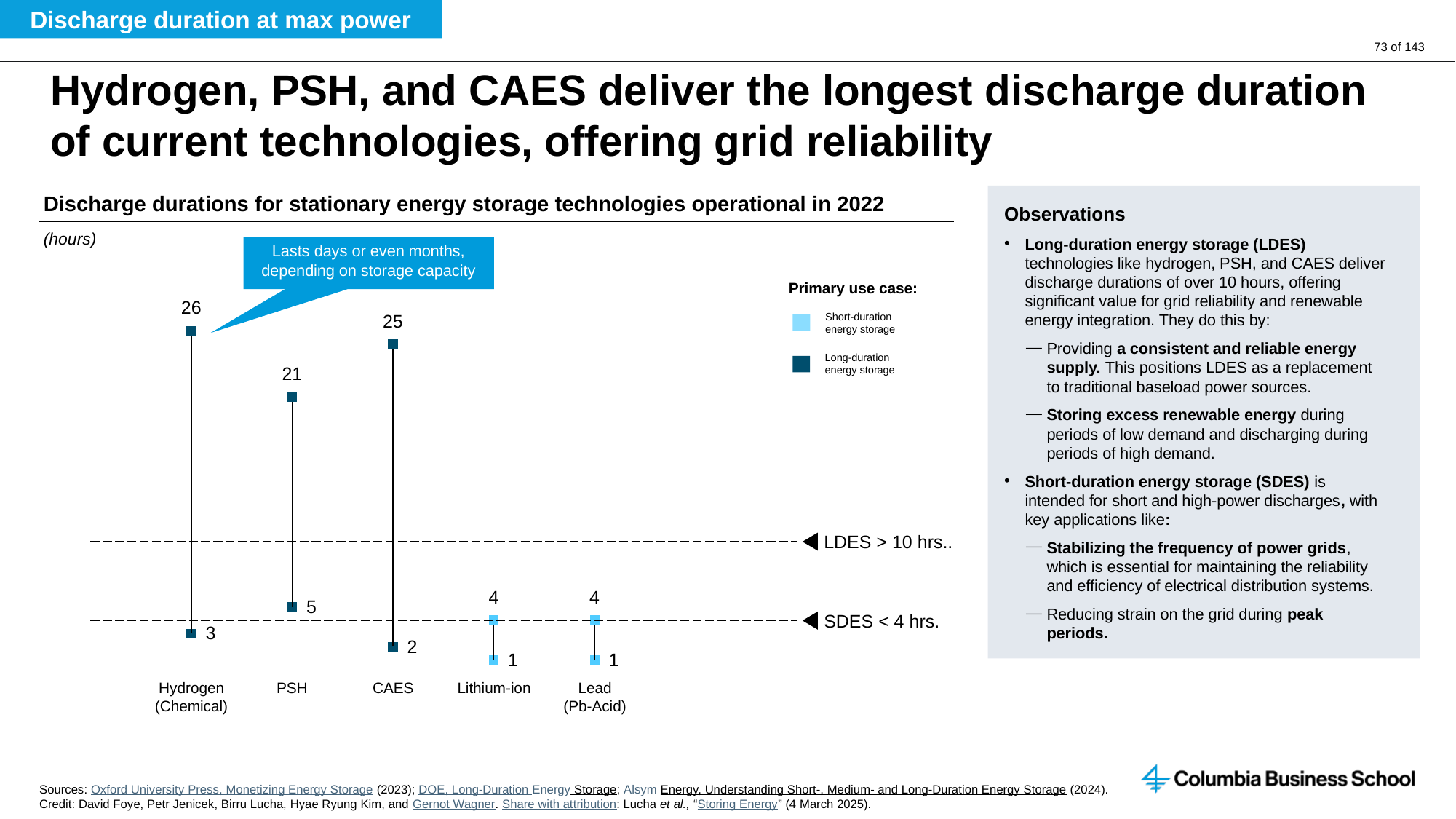
In what unit are the discharge durations shown? hours Which technology has the highest maximum discharge duration? Hydrogen (Chemical) What is the minimum discharge duration shown for CAES? 2 How many energy storage technologies are shown on the x axis? 5 What is the maximum discharge duration shown for CAES? 25 What is the maximum discharge duration shown for Hydrogen (Chemical)? 26 What is the difference between the maximum discharge durations of CAES and PSH? 4 What is the maximum discharge duration shown for Lithium-ion? 4 Which has a higher maximum discharge duration, PSH or CAES? CAES What is the difference between the maximum and minimum discharge duration for Hydrogen (Chemical)? 23 How many entries does the legend list? 2 What is the minimum discharge duration shown for PSH? 5